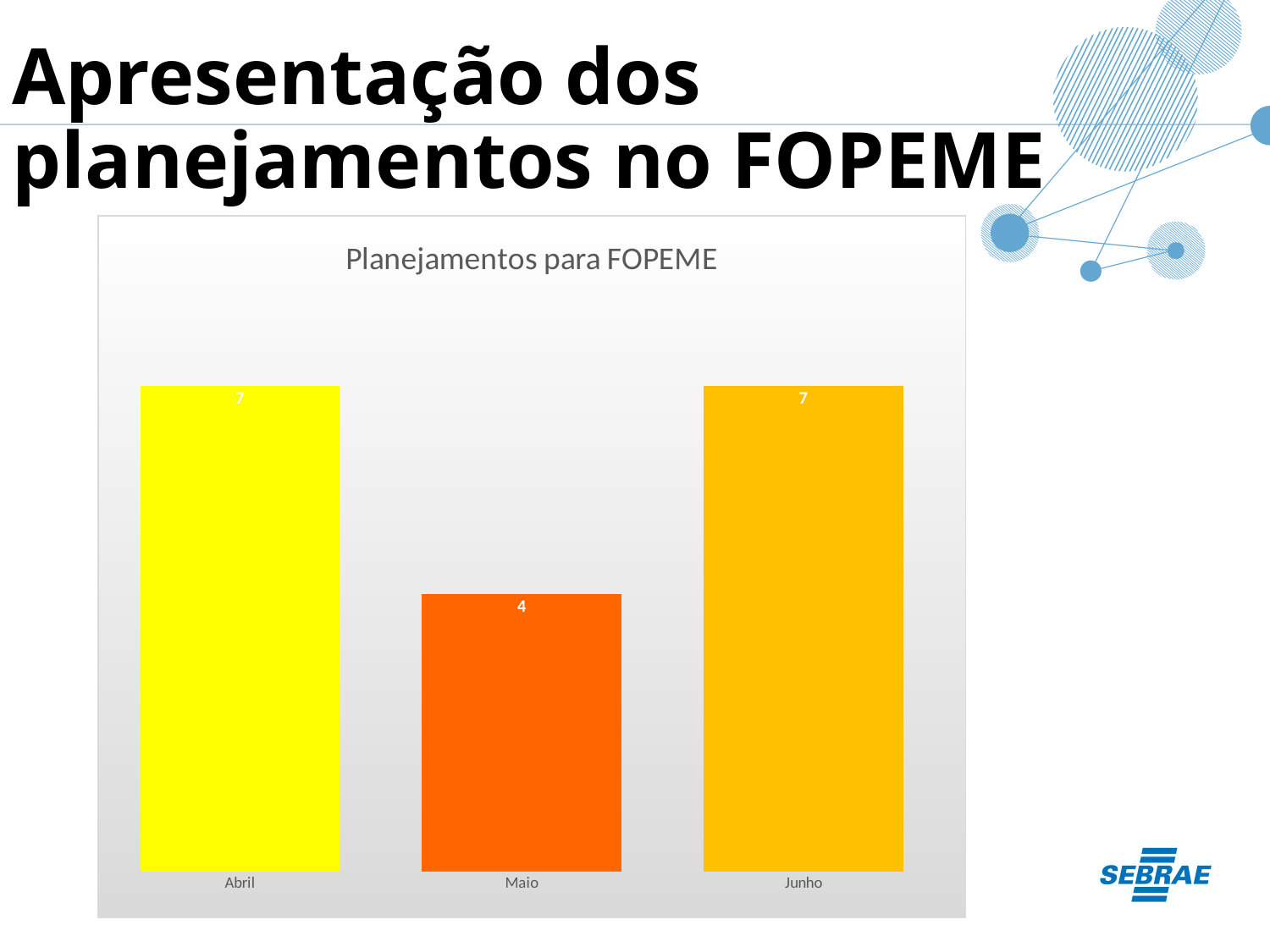
What is the value for Abril? 7 Which is larger, the value for Maio or the value for Junho? Junho What is the title of the chart? Planejamentos para FOPEME What is the difference between the values for Junho and Maio? 3 What is the value for Junho? 7 What is the value for Maio? 4 Which month has the lowest value? Maio What kind of chart is shown on the slide? bar chart How many categories are shown on the chart? 3 What colour is the bar for Maio? orange What is the total of the values for Abril, Maio and Junho? 18 What is the difference between the values for Abril and Maio? 3